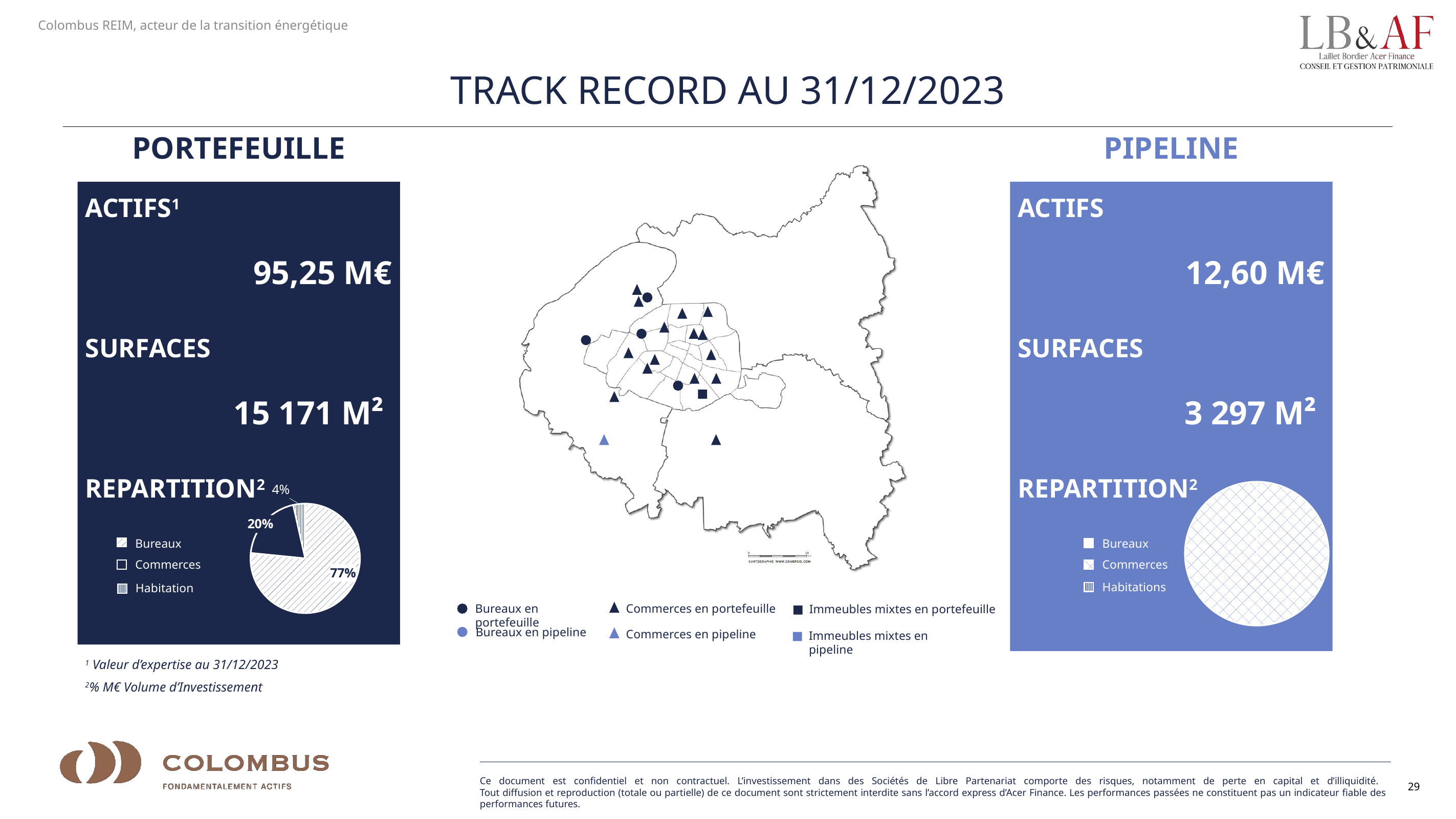
In the Pipeline REPARTITION pie chart, which legend category's pattern fills the entire pie? Commerces In the Portefeuille REPARTITION pie chart, which category has the largest share? Bureaux In the Portefeuille REPARTITION pie chart, which category has the smallest share? Habitation In the Portefeuille REPARTITION pie chart, what are the three legend entries? Bureaux, Commerces, Habitation In the Portefeuille REPARTITION pie chart, which is larger: the Commerces share or the Habitation share? Commerces In the Portefeuille REPARTITION pie chart, what share is shown for Bureaux? 77% How many categories does the Portefeuille REPARTITION pie chart show? 3 In the Portefeuille REPARTITION pie chart, what share is shown for Habitation? 4% In the Portefeuille REPARTITION pie chart, what share is shown for Commerces? 20% In the Portefeuille REPARTITION pie chart, what is the difference between the Bureaux share and the Commerces share? 57% How many entries does the legend of the Pipeline REPARTITION pie chart list? 3 What kind of chart is used for the Portefeuille REPARTITION? Pie chart